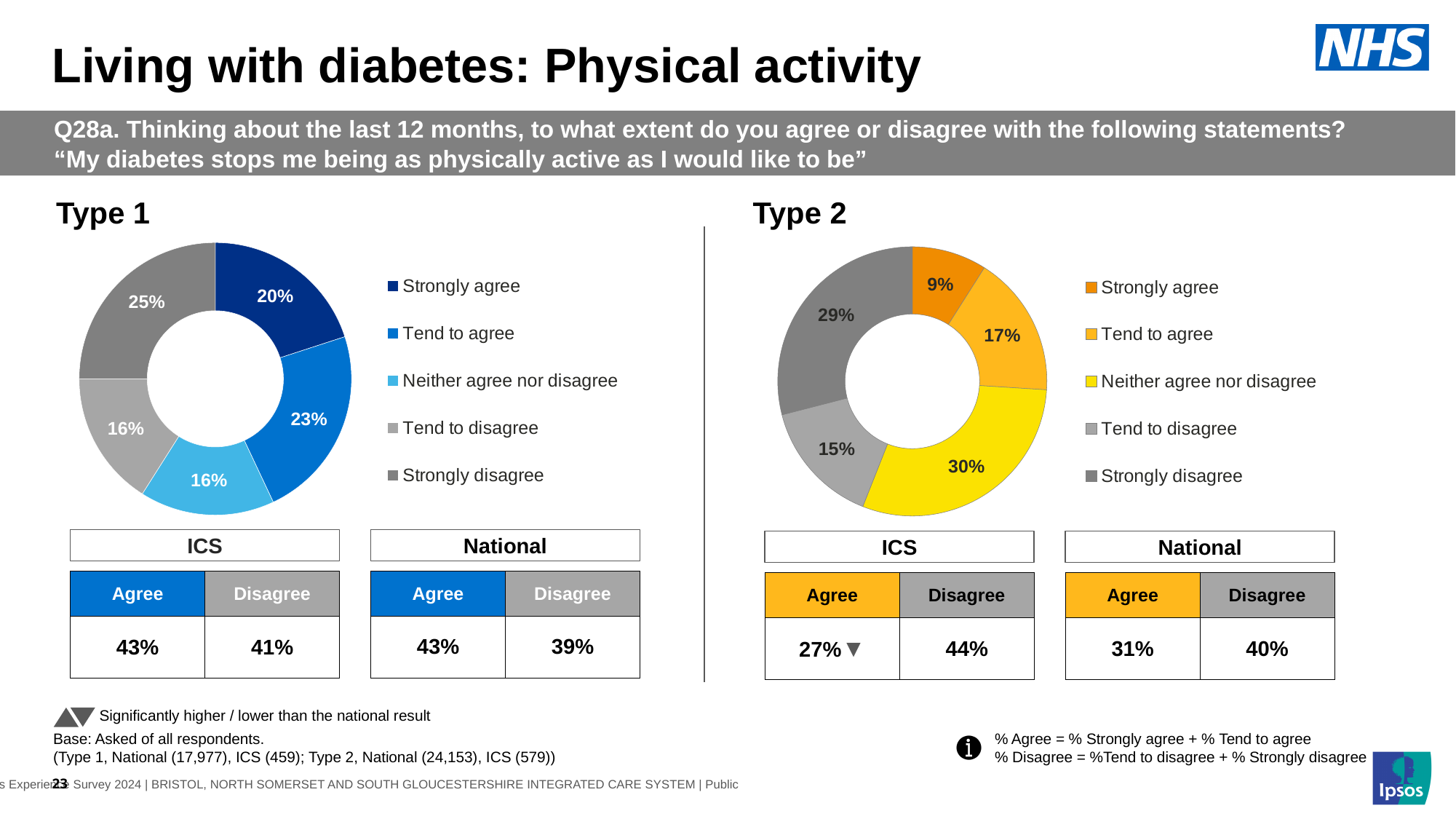
In the Type 1 chart, what percentage of respondents said they strongly agree? 20% In the Type 1 chart, what is the difference between the Strongly disagree and Strongly agree shares? 5% What kind of chart is used to show the Type 2 results? Pie (donut) chart In the Type 1 chart, which response category has the largest share? Strongly disagree In the Type 2 chart, which is larger: the Tend to agree share or the Tend to disagree share? Tend to agree In the Type 1 chart, what percentage of respondents said they tend to agree? 23% In the Type 2 chart, what percentage of respondents said they strongly disagree? 29% In the Type 2 chart, what is the difference between the Tend to agree and Strongly agree shares? 8% How many response categories does the legend of the Type 1 chart list? 5 In the Type 2 chart, what percentage of respondents said they neither agree nor disagree? 30% In the Type 2 chart, which response category has the largest share? Neither agree nor disagree In the Type 2 chart, which response category has the smallest share? Strongly agree